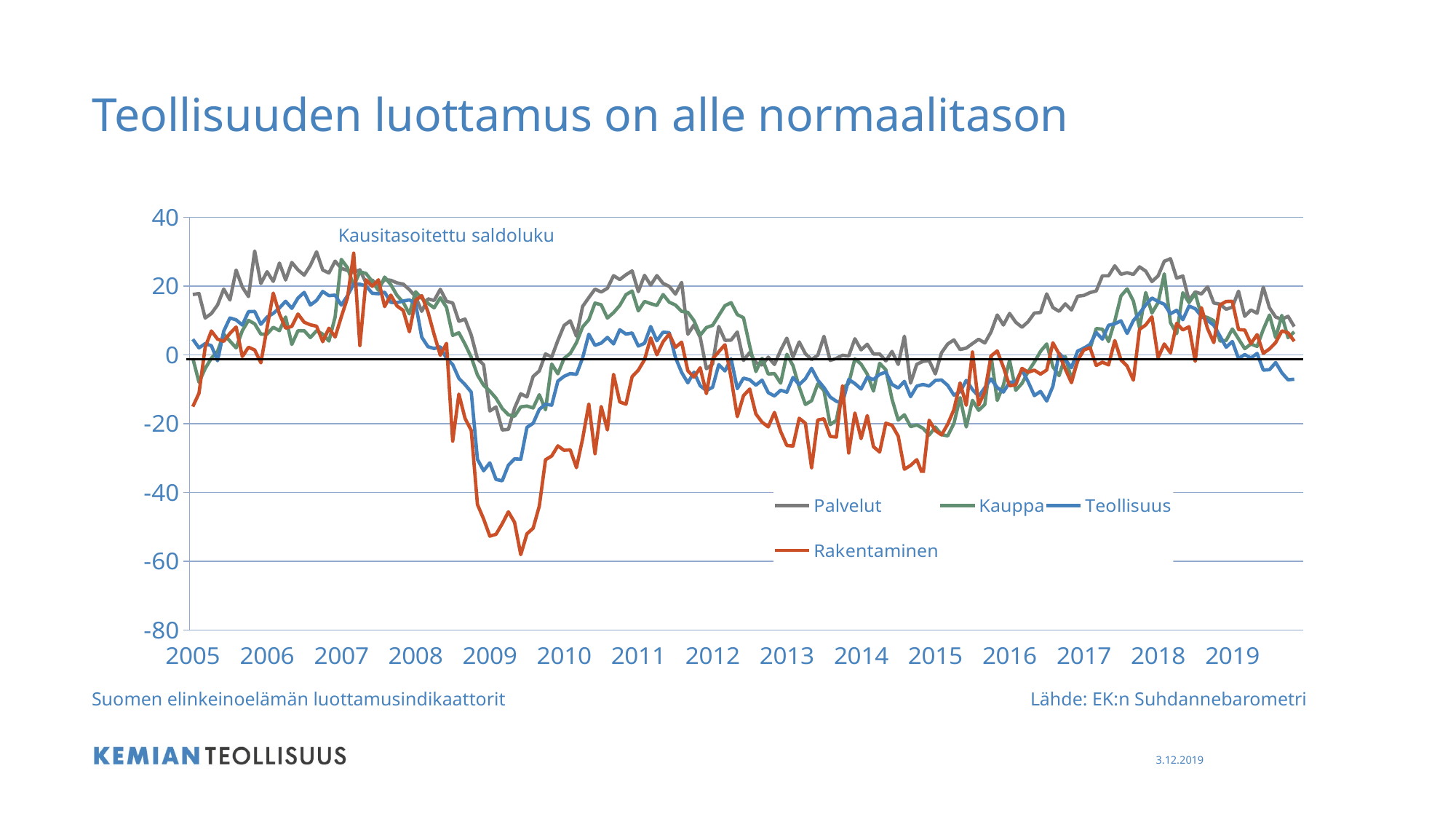
Is the lowest value of Rakentaminen in 2009 greater or less than -40? less Is the lowest value of Teollisuus in 2009 greater or less than -20? less Which series are listed in the legend? Palvelut, Kauppa, Teollisuus, Rakentaminen Is the Teollisuus value at the end of 2019 greater or less than 0? less How many year labels are shown on the x axis? 15 What is the title of the slide? Teollisuuden luottamus on alle normaalitason Does the Teollisuus series rise or fall from early 2018 to the end of 2019? fall Which series reaches the lowest value during 2009? Rakentaminen How many series does the legend list? 4 Which series has the lowest value at the end of 2019? Teollisuus What kind of chart is shown on the slide? line chart